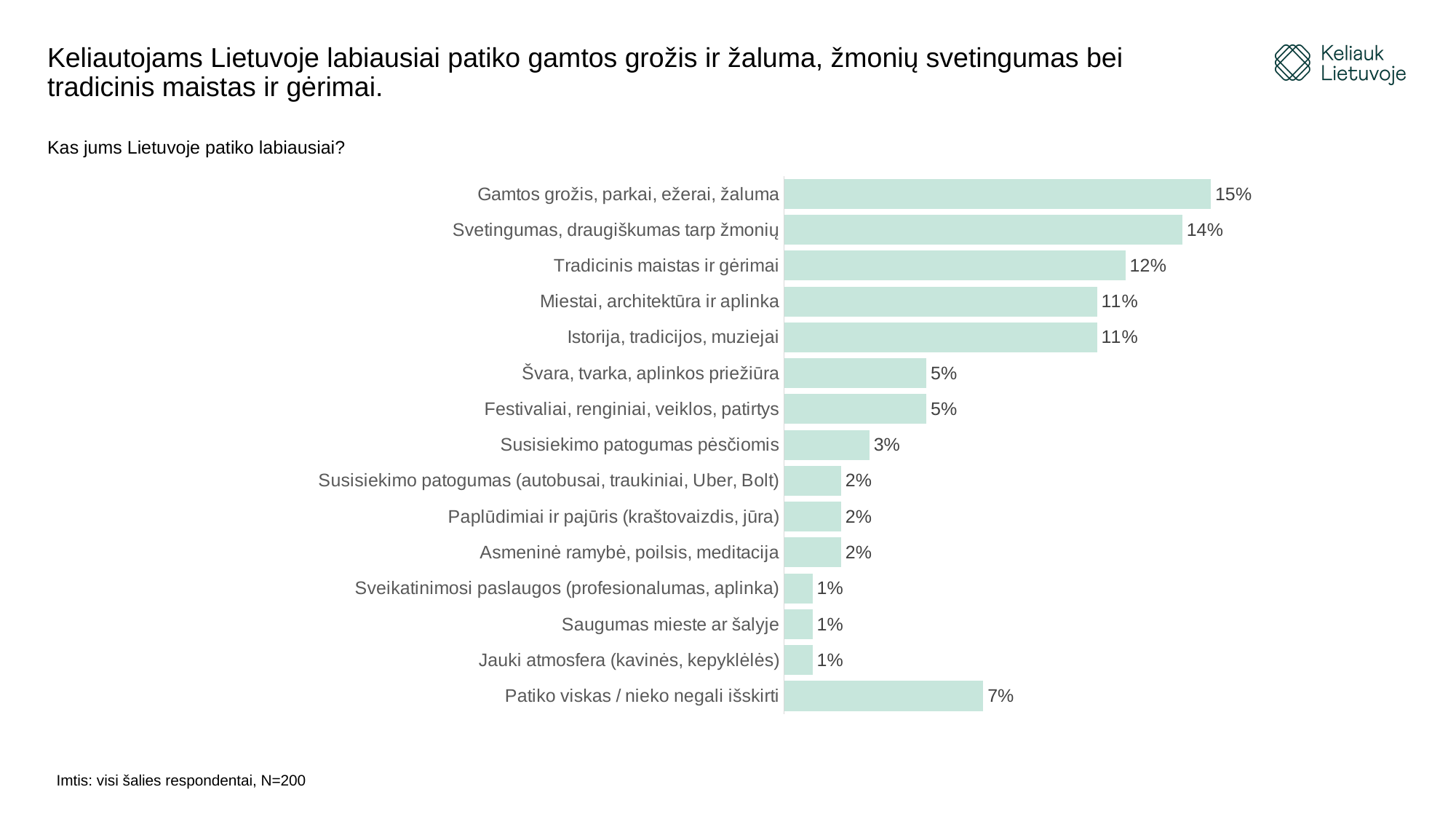
What is the value for "Susisiekimo patogumas pėsčiomis"? 3% What is the value for "Tradicinis maistas ir gėrimai"? 12% How many categories have a value of 1%? 3 Which category has the highest value? Gamtos grožis, parkai, ežerai, žaluma What kind of chart is shown on the slide? Bar chart Which is larger: "Patiko viskas / nieko negali išskirti" or "Festivaliai, renginiai, veiklos, patirtys"? Patiko viskas / nieko negali išskirti What is the value for "Patiko viskas / nieko negali išskirti"? 7% What is the difference between "Tradicinis maistas ir gėrimai" and "Švara, tvarka, aplinkos priežiūra"? 7% What is the difference between "Gamtos grožis, parkai, ežerai, žaluma" and "Svetingumas, draugiškumas tarp žmonių"? 1% How many categories are shown in the chart? 15 What percentage of respondents chose "Gamtos grožis, parkai, ežerai, žaluma"? 15% What is the sample size stated at the bottom of the slide? N=200